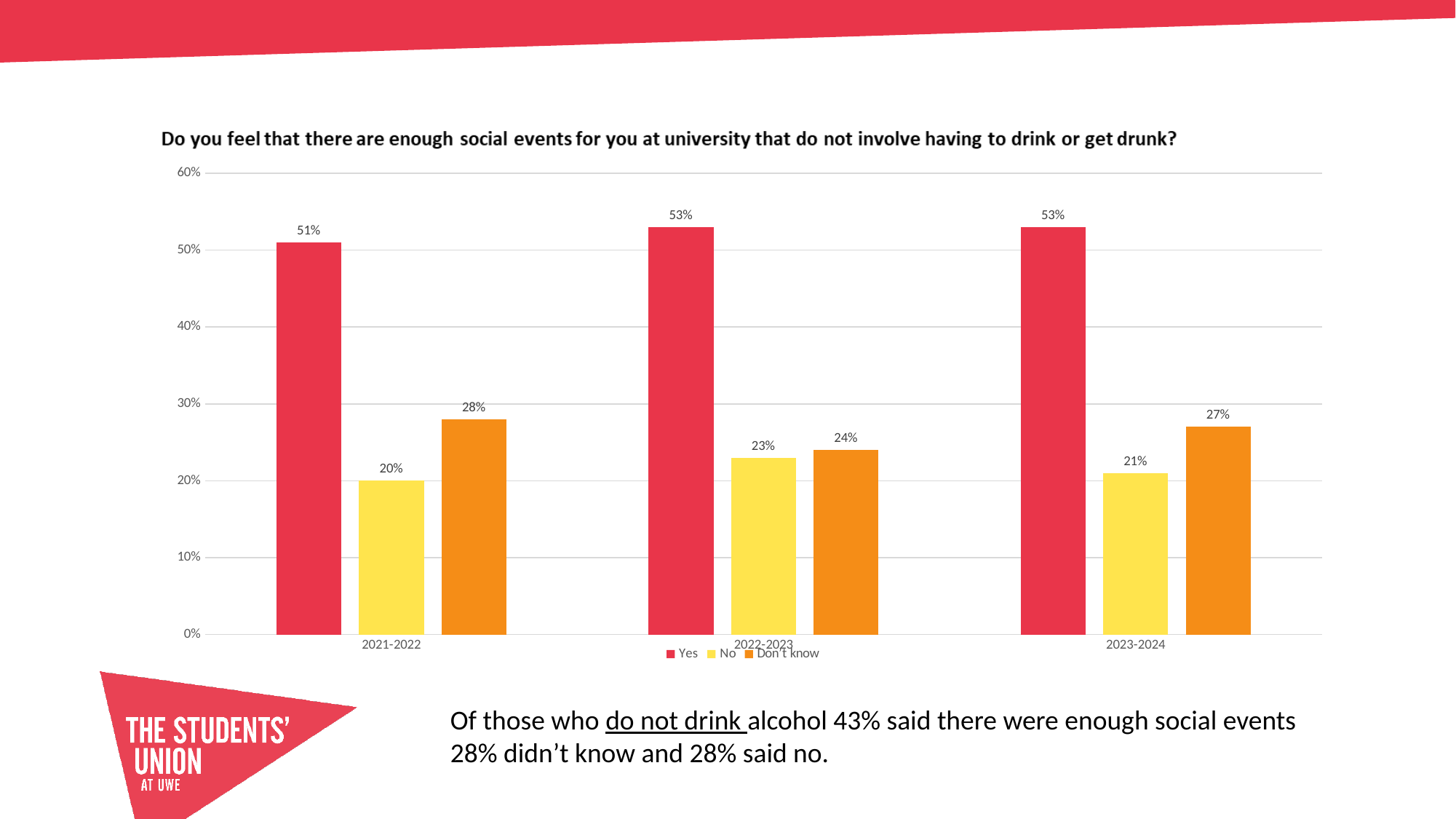
What percentage answered Yes in 2021-2022? 51% In which year was the No response lowest? 2021-2022 In which year was the Don't know response highest? 2021-2022 What is the difference between the Yes and No percentages in 2023-2024? 32% Which colour represents the Yes series? Red What percentage answered Don't know in 2023-2024? 27% How many academic years are shown on the x axis? 3 Which is larger in 2022-2023, the No or the Don't know percentage? Don't know How many series does the legend list? 3 What percentage answered No in 2022-2023? 23% What kind of chart is shown? Bar chart Is the Yes value for 2022-2023 greater or less than 50%? greater